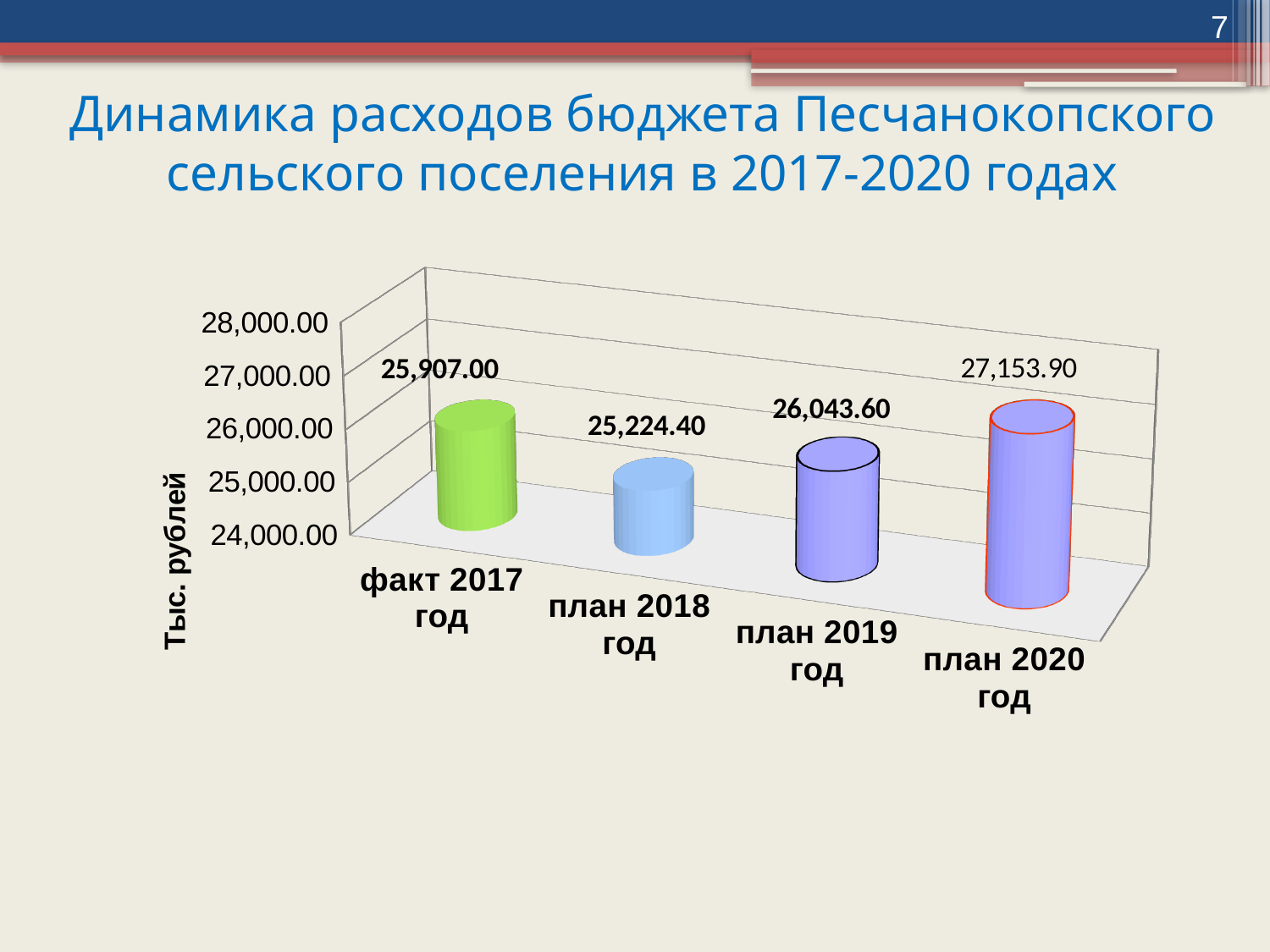
How many categories are shown on the chart? 4 Which is larger, the value for факт 2017 год or the value for план 2018 год? факт 2017 год What is the value for план 2019 год? 26,043.60 What kind of chart is shown on the slide? bar chart What is the value for план 2020 год? 27,153.90 What is the label of the vertical axis? Тыс. рублей What is the difference between the values for план 2020 год and факт 2017 год? 1,246.90 What is the value for факт 2017 год? 25,907.00 What is the value for план 2018 год? 25,224.40 What is the difference between the values for план 2019 год and план 2018 год? 819.20 Which category has the highest value? план 2020 год Which category has the lowest value? план 2018 год